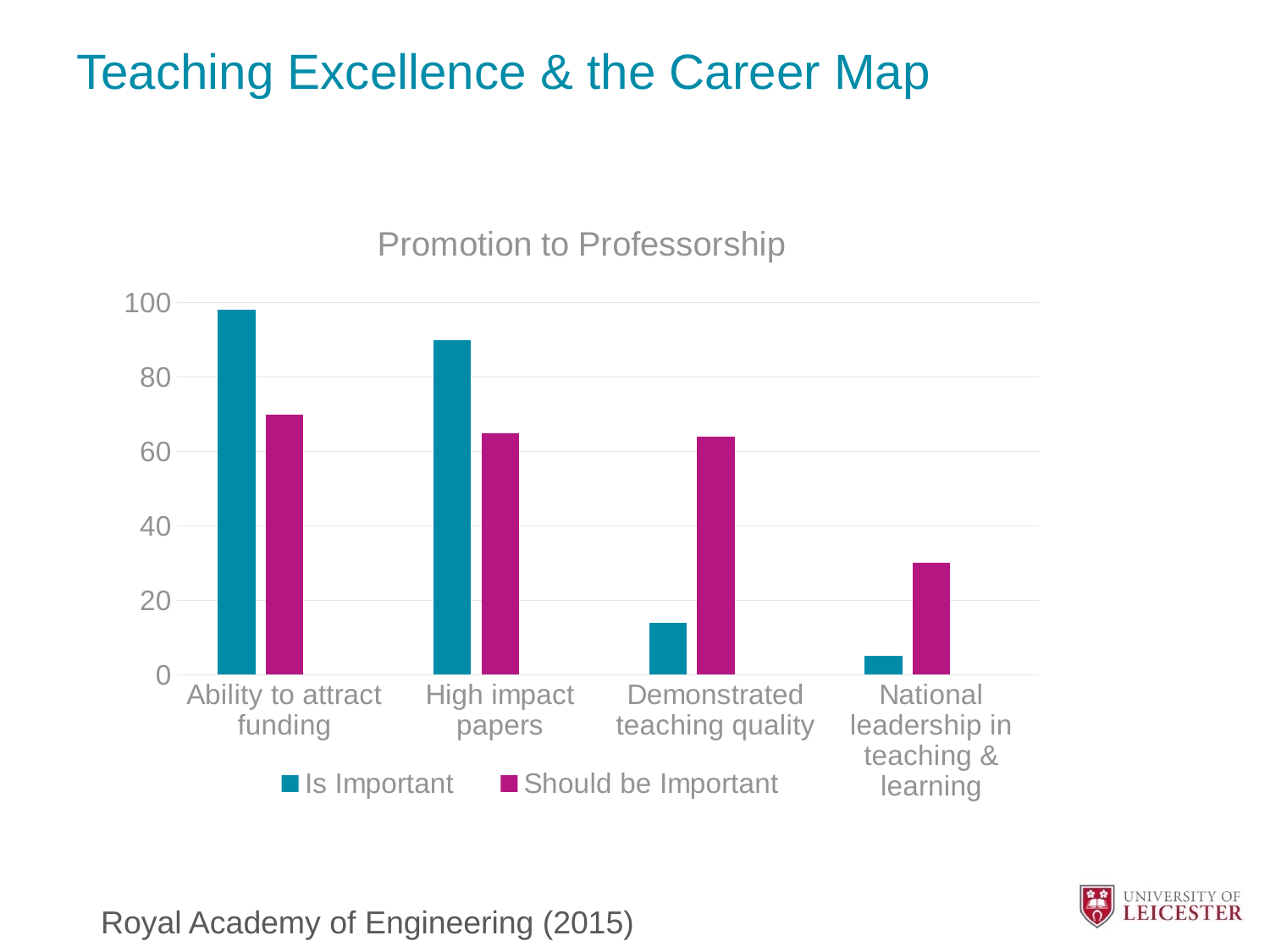
For Demonstrated teaching quality, which is larger: 'Is Important' or 'Should be Important'? Should be Important What kind of chart is shown on the slide? bar chart Which category has the lowest 'Is Important' value? National leadership in teaching & learning What is the title of the chart? Promotion to Professorship Is the 'Is Important' value for Demonstrated teaching quality greater or less than 20? less Which category has the highest 'Is Important' value? Ability to attract funding For High impact papers, which is larger: 'Is Important' or 'Should be Important'? Is Important How many categories are shown on the x axis? 4 Is the 'Is Important' value for Ability to attract funding greater or less than 80? greater How many series does the legend list? 2 Which category has the lowest 'Should be Important' value? National leadership in teaching & learning Is the 'Should be Important' value for Demonstrated teaching quality greater or less than 60? greater